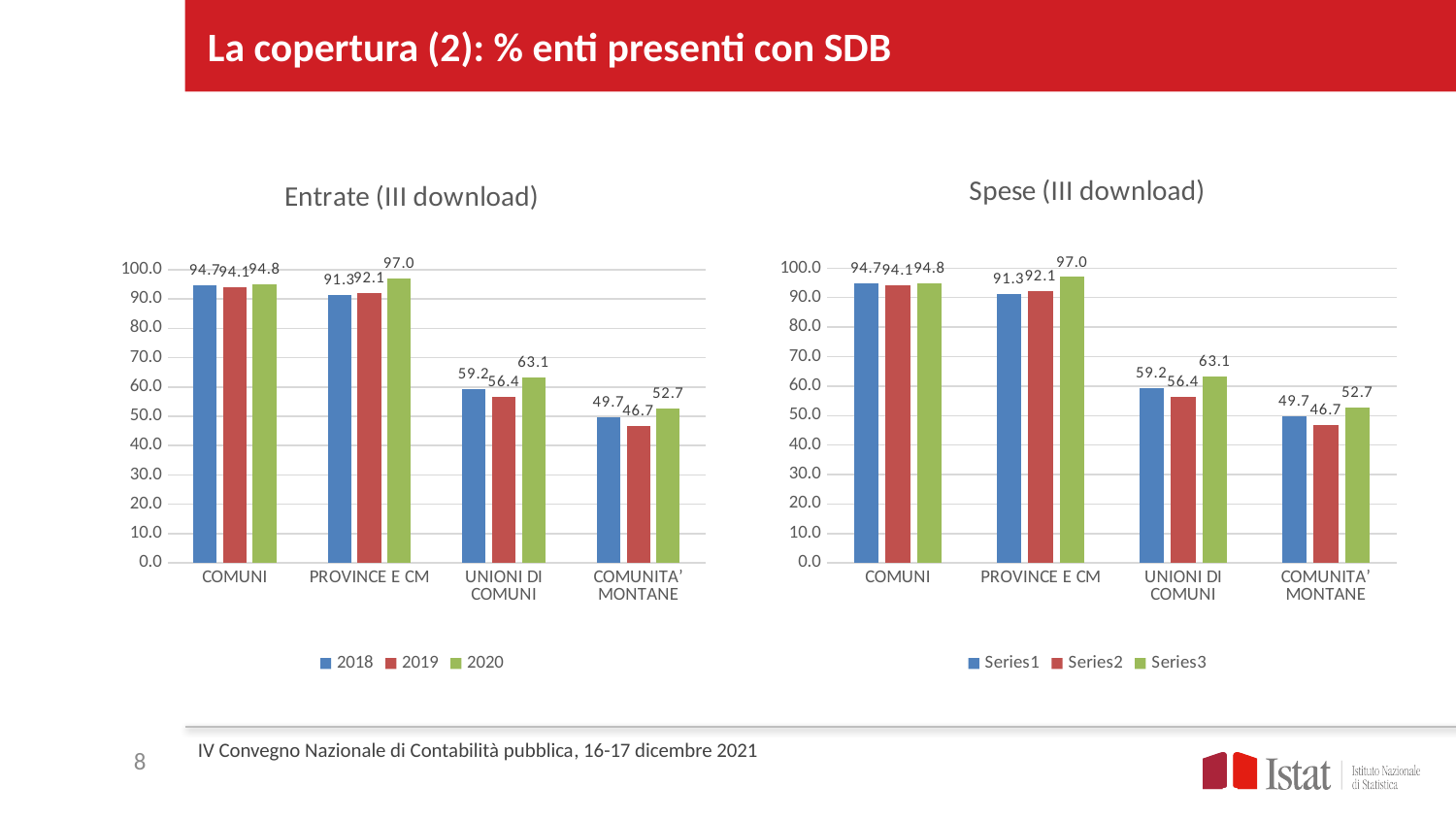
What are the legend entries of the 'Spese (III download)' chart? Series1, Series2, Series3 In the 'Entrate (III download)' chart, is the 2018 value for UNIONI DI COMUNI greater or less than 50.0? greater In the 'Entrate (III download)' chart, which category has the lowest value in 2020? COMUNITA' MONTANE In the 'Entrate (III download)' chart, what is the difference between the 2020 and 2019 values for UNIONI DI COMUNI? 6.7 In the 'Entrate (III download)' chart, what is the value for UNIONI DI COMUNI in 2019? 56.4 In the 'Spese (III download)' chart, which category has the highest value in Series3? PROVINCE E CM How many categories are shown on the x axis of the 'Spese (III download)' chart? 4 In the 'Spese (III download)' chart, what is the value for COMUNITA' MONTANE in Series1? 49.7 In the 'Entrate (III download)' chart, what is the value for PROVINCE E CM in 2020? 97.0 In the 'Spese (III download)' chart, which is larger for COMUNITA' MONTANE: Series1 or Series2? Series1 How many series does the legend of the 'Entrate (III download)' chart list? 3 What type of chart is the 'Spese (III download)' chart? Bar chart